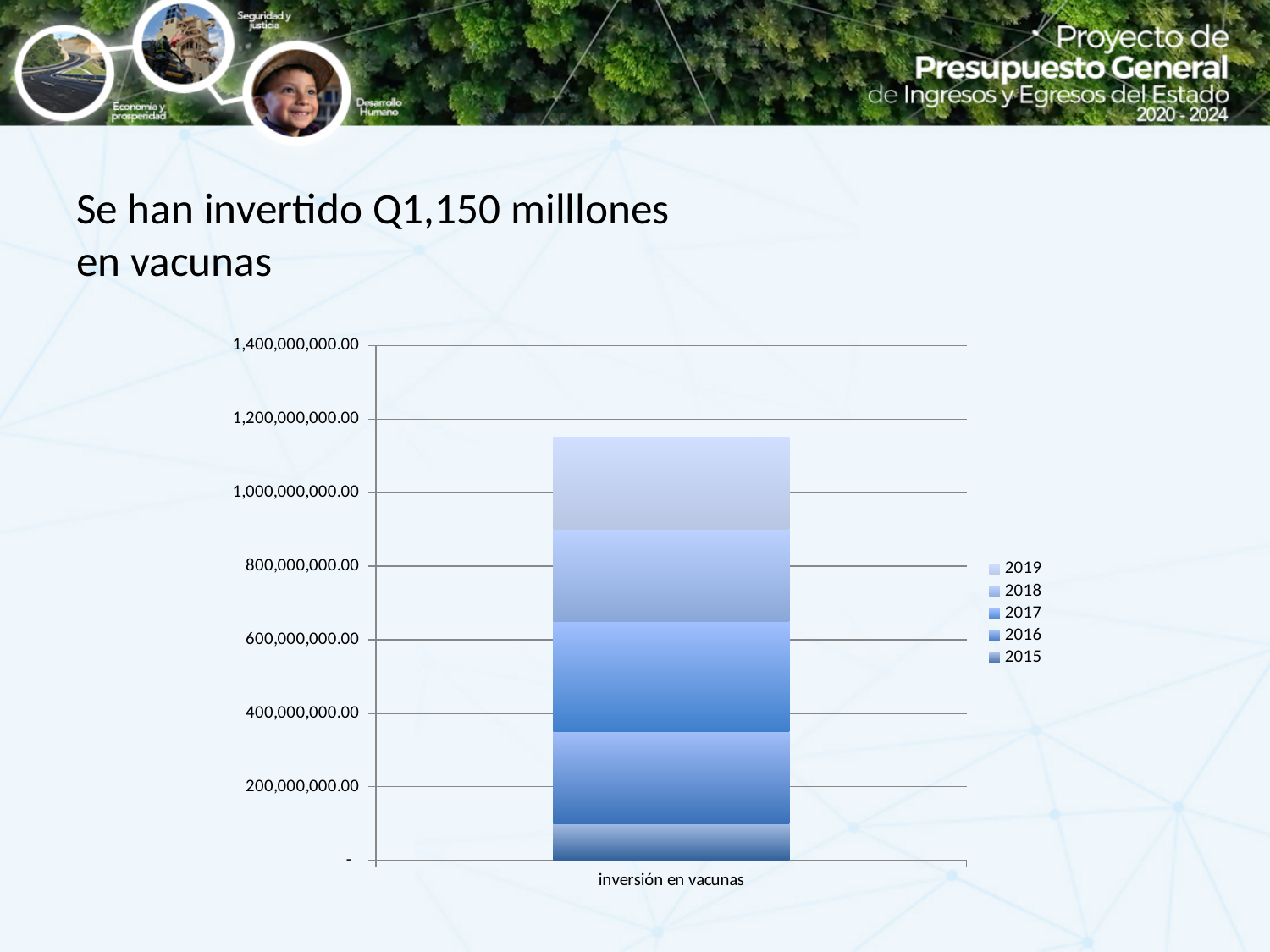
Is the 2015 segment of the stacked bar greater or less than 200,000,000.00? less Is the total height of the stacked bar greater or less than 1,000,000,000.00? greater Which segment is larger, 2017 or 2015? 2017 What is the label of the category on the x axis? inversión en vacunas Which years are listed in the legend? 2019, 2018, 2017, 2016, 2015 Which series is at the bottom of the stacked bar? 2015 What kind of chart is shown on the slide? bar chart Is the total height of the stacked bar greater or less than 1,200,000,000.00? less How many categories are shown on the x axis? 1 Which year has the smallest segment in the stacked bar? 2015 How many series does the legend list? 5